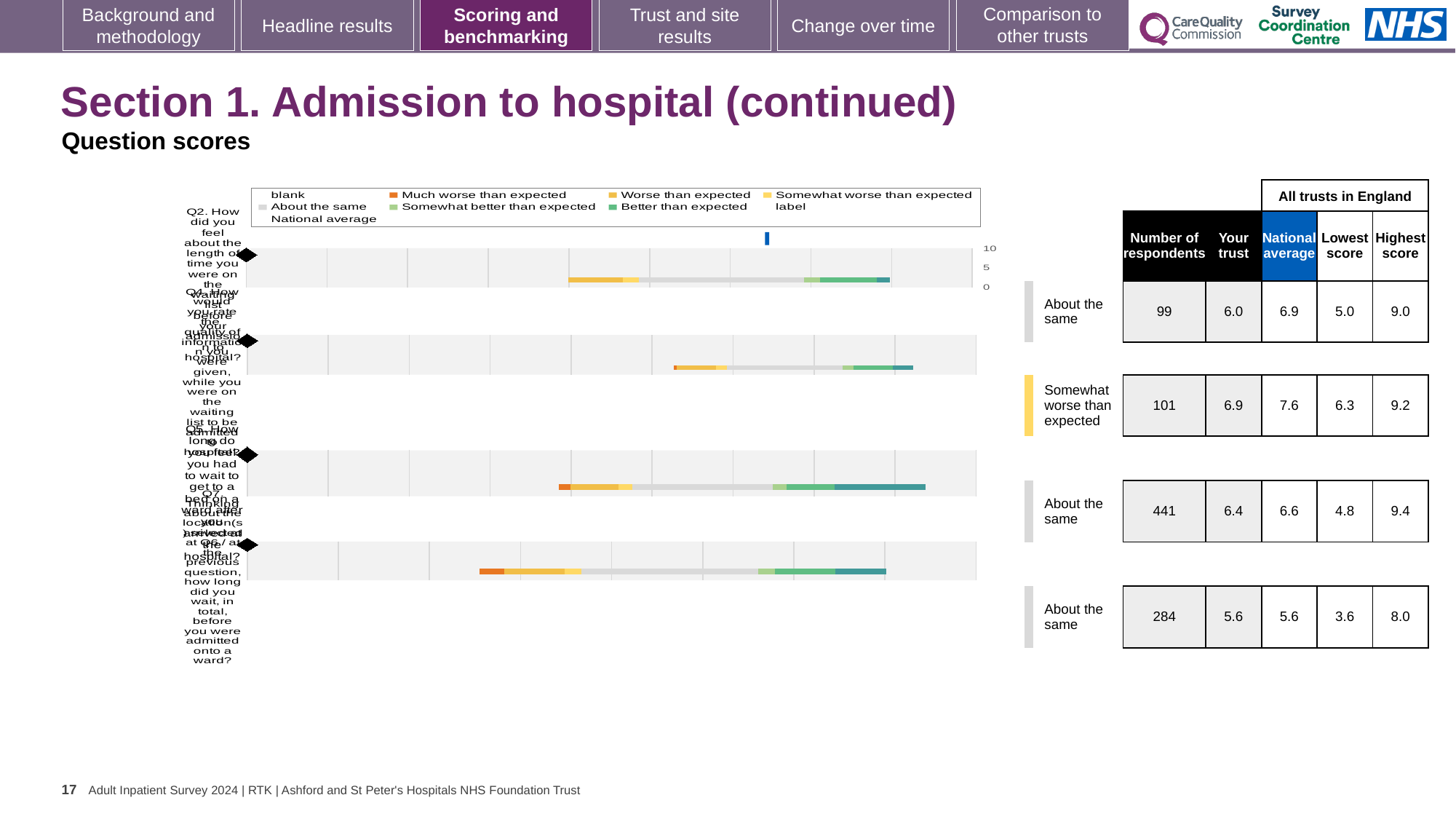
What kind of chart is shown on the slide? bar chart How many question rows (bars) are plotted in the chart? 4 For the row labelled 'Somewhat worse than expected', how much higher is the national average than the 'Your trust' score? 0.7 In the table, what is the national average for the row labelled 'Somewhat worse than expected'? 7.6 In the table, what is the highest score for the row with 284 respondents? 8.0 What is the lowest 'Your trust' score shown in the table? 5.6 What colour does the legend use for 'Much worse than expected'? orange What is the highest number of respondents shown in the table? 441 In the first row of the table, which is larger: the 'Your trust' score or the national average? National average What colour does the legend use for 'Better than expected'? teal green In the table, how many respondents are shown for the row labelled 'Somewhat worse than expected'? 101 In the table, what is the 'Your trust' score for the row labelled 'Somewhat worse than expected'? 6.9